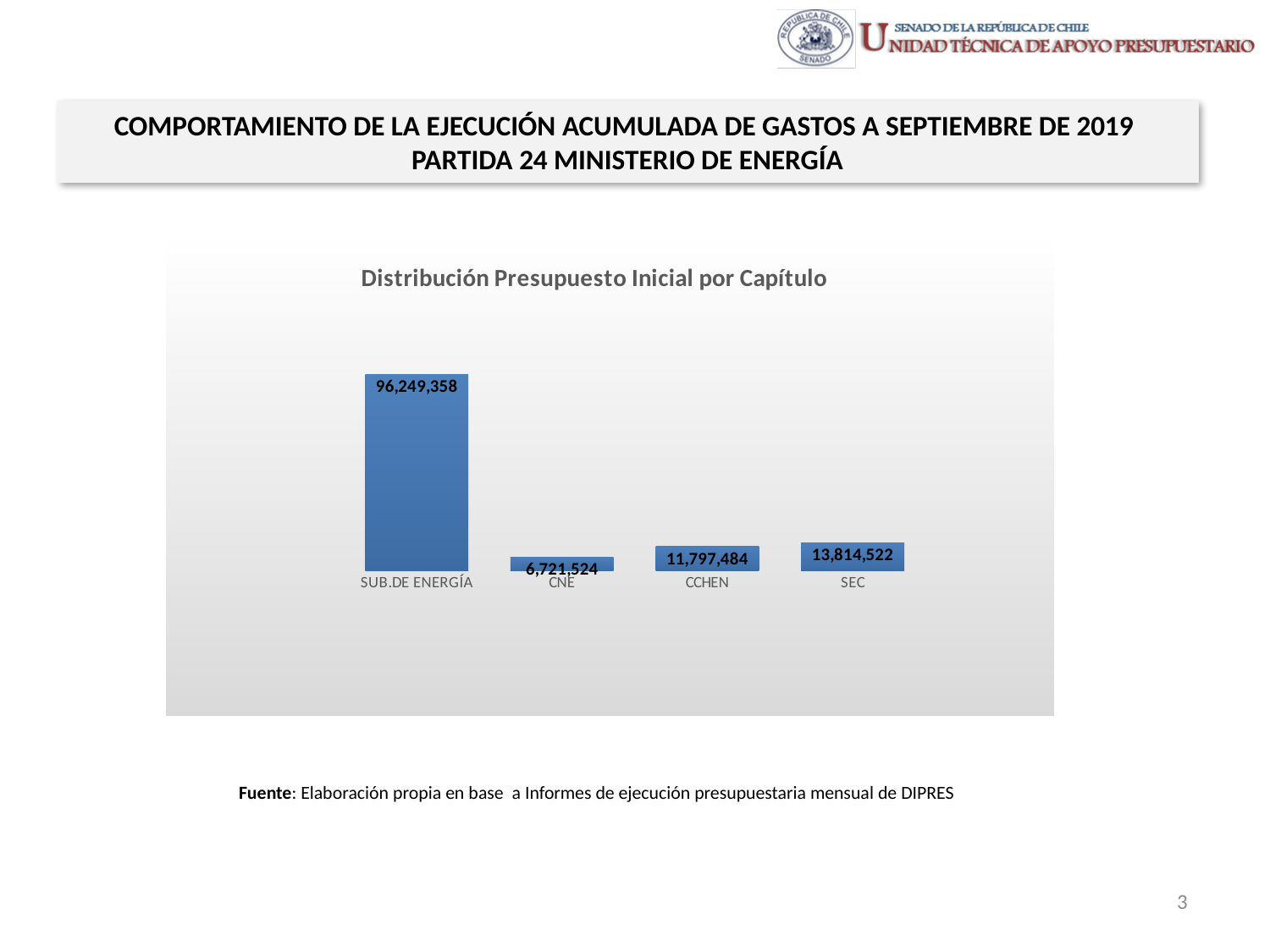
Which category has the highest value in the chart? SUB.DE ENERGÍA What is the value for CCHEN in the chart? 11,797,484 What is the value for SEC in the chart? 13,814,522 What is the title of the chart? Distribución Presupuesto Inicial por Capítulo What is the difference between the values for SUB.DE ENERGÍA and CNE? 89,527,834 What is the value for SUB.DE ENERGÍA in the chart? 96,249,358 What is the value for CNE in the chart? 6,721,524 How many categories are shown in the chart? 4 What is the difference between the values for SEC and CCHEN? 2,017,038 Which is larger, the value for CCHEN or the value for SEC? SEC Which category has the lowest value in the chart? CNE What kind of chart is shown on the slide? Bar chart